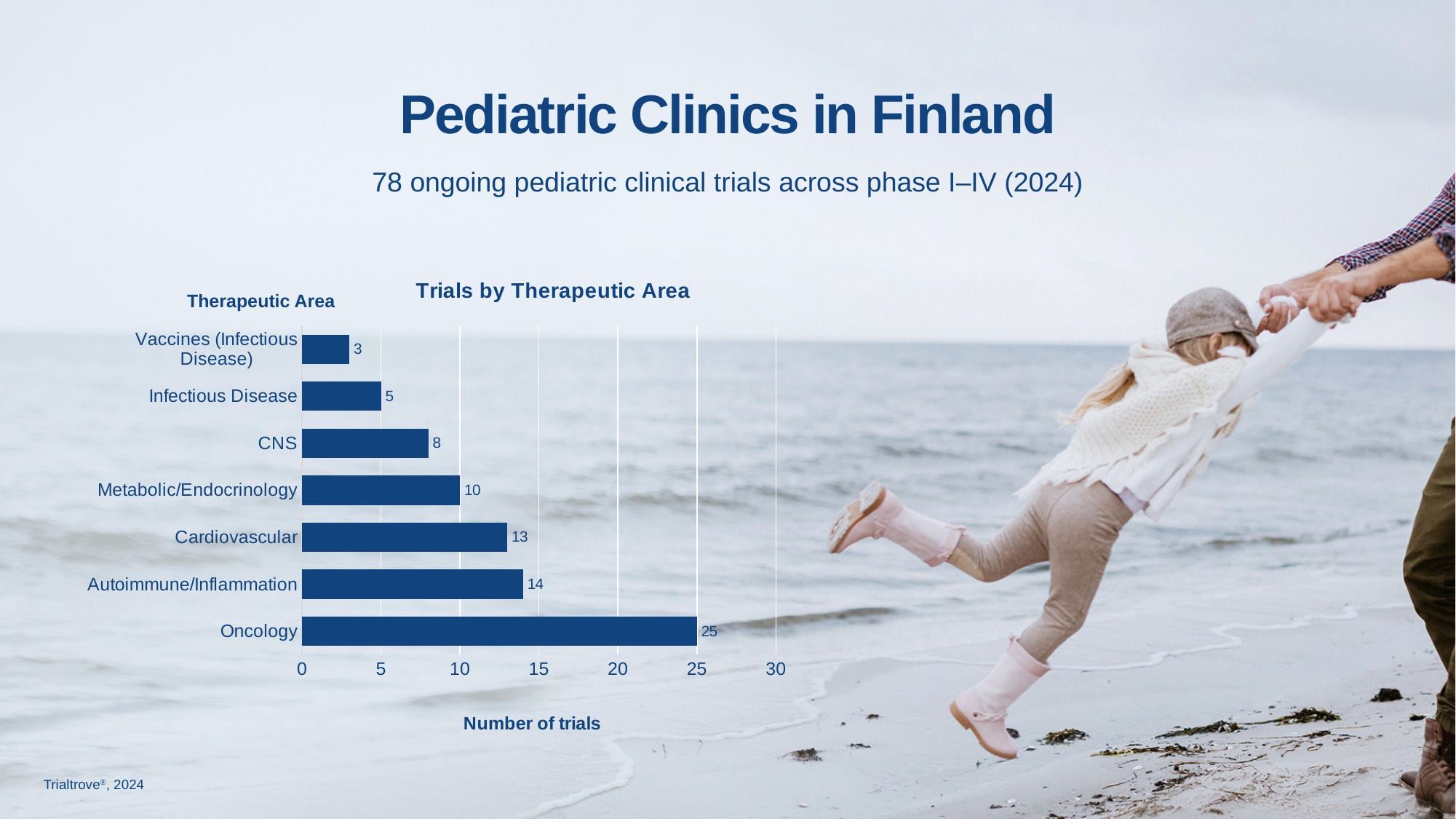
What is the difference in number of trials between Oncology and Autoimmune/Inflammation? 11 What is the number of trials for CNS? 8 Is the value for Autoimmune/Inflammation greater or less than 10? greater Which has more trials, Cardiovascular or Metabolic/Endocrinology? Cardiovascular Which therapeutic area has the lowest number of trials? Vaccines (Infectious Disease) How many trials are shown for Vaccines (Infectious Disease)? 3 Which therapeutic area has the highest number of trials? Oncology What is the title of the chart? Trials by Therapeutic Area How many therapeutic areas are shown in the chart? 7 How many trials are shown for Oncology? 25 What is the label of the horizontal axis? Number of trials What kind of chart is used to show trials by therapeutic area? Bar chart